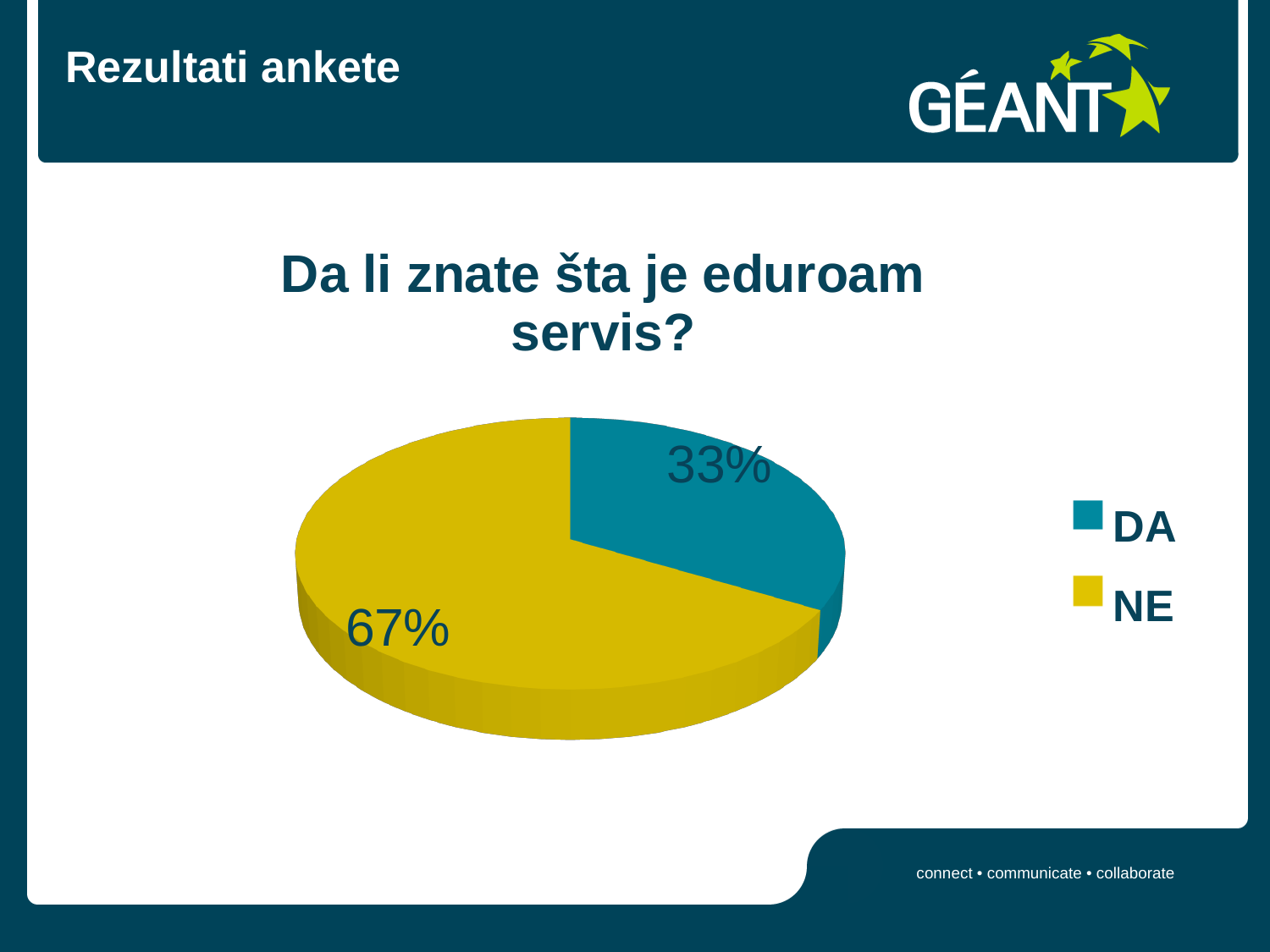
Which category has the smallest share of the pie? DA Which is larger, the share for DA or the share for NE? NE What percentage of the pie is labelled for DA? 33% What colour is the slice for DA? teal blue Which category has the largest share of the pie? NE What is the share of the pie for NE? 67% How many slices does the pie chart have? 2 How many entries does the legend list? 2 What kind of chart is shown on the slide? pie chart What is the difference in percentage points between the NE share and the DA share? 34 What is the title of the chart? Da li znate šta je eduroam servis? What percentage of the pie is labelled for NE? 67%